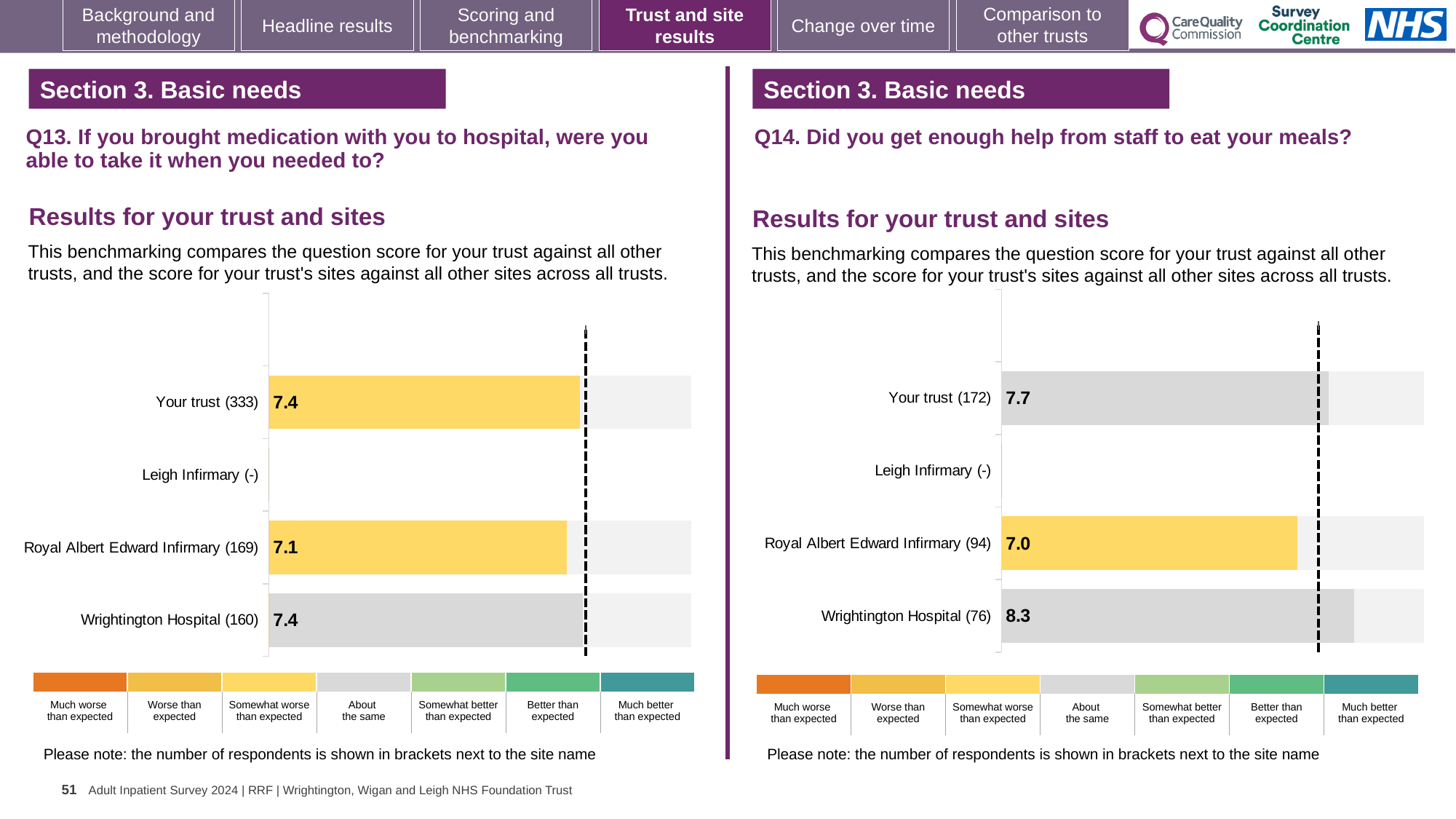
In the Q14 chart (right), which site has the highest score? Wrightington Hospital In the Q14 chart (right), what is the score for Your trust? 7.7 In the Q13 chart (left), which site has the lowest score? Royal Albert Edward Infirmary What kind of chart is used for the Q13 results (left)? Bar chart In the Q13 chart (left), what is the score for Wrightington Hospital? 7.4 In the Q13 chart (left), what is the score for Your trust? 7.4 In the Q14 chart (right), what is the score for Wrightington Hospital? 8.3 In the Q14 chart (right), which has the larger score, Your trust or Royal Albert Edward Infirmary? Your trust In the Q13 chart (left), what is the score for Royal Albert Edward Infirmary? 7.1 In the Q13 chart (left), what is the difference between the scores for Wrightington Hospital and Royal Albert Edward Infirmary? 0.3 In the Q14 chart (right), what is the difference between the scores for Wrightington Hospital and Royal Albert Edward Infirmary? 1.3 In the Q14 chart (right), what is the score for Royal Albert Edward Infirmary? 7.0